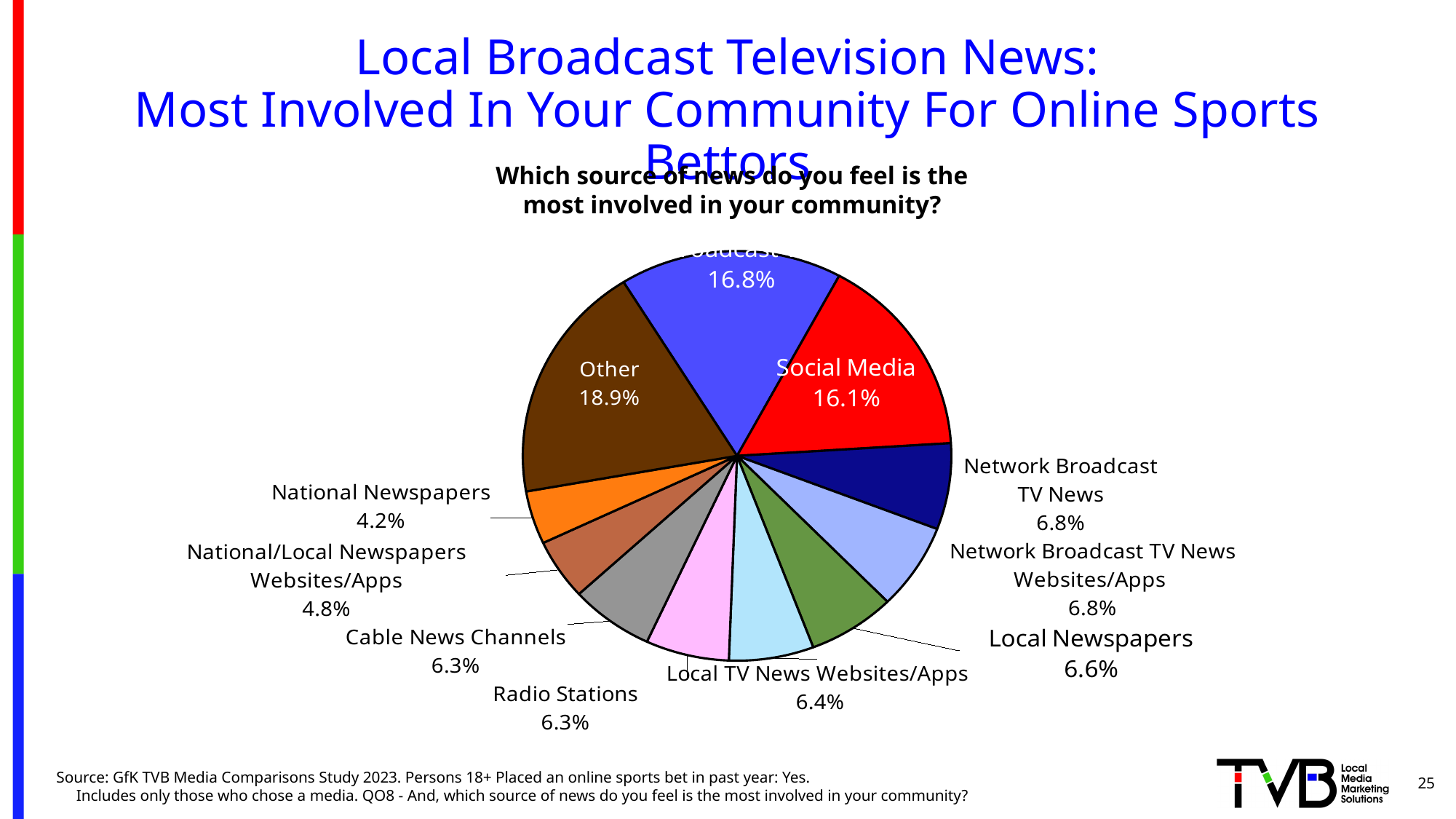
What is the value shown for the Other slice of the pie chart? 18.9% Which has a larger share: Local Newspapers or Local TV News Websites/Apps? Local Newspapers How many percentage points larger is the Other slice than the Social Media slice? 2.8% What percentage is shown for Local Newspapers? 6.6% What percentage is shown for National/Local Newspapers Websites/Apps? 4.8% What is the difference between Network Broadcast TV News (6.8%) and National Newspapers (4.2%)? 2.6% What percentage is shown for Radio Stations? 6.3% What colour is the Social Media slice of the pie chart? red What percentage of online sports bettors chose Social Media as the news source most involved in their community? 16.1% What type of chart is shown on the slide? pie chart Which slice of the pie chart has the smallest share? National Newspapers Which labeled slice of the pie chart has the largest share? Other